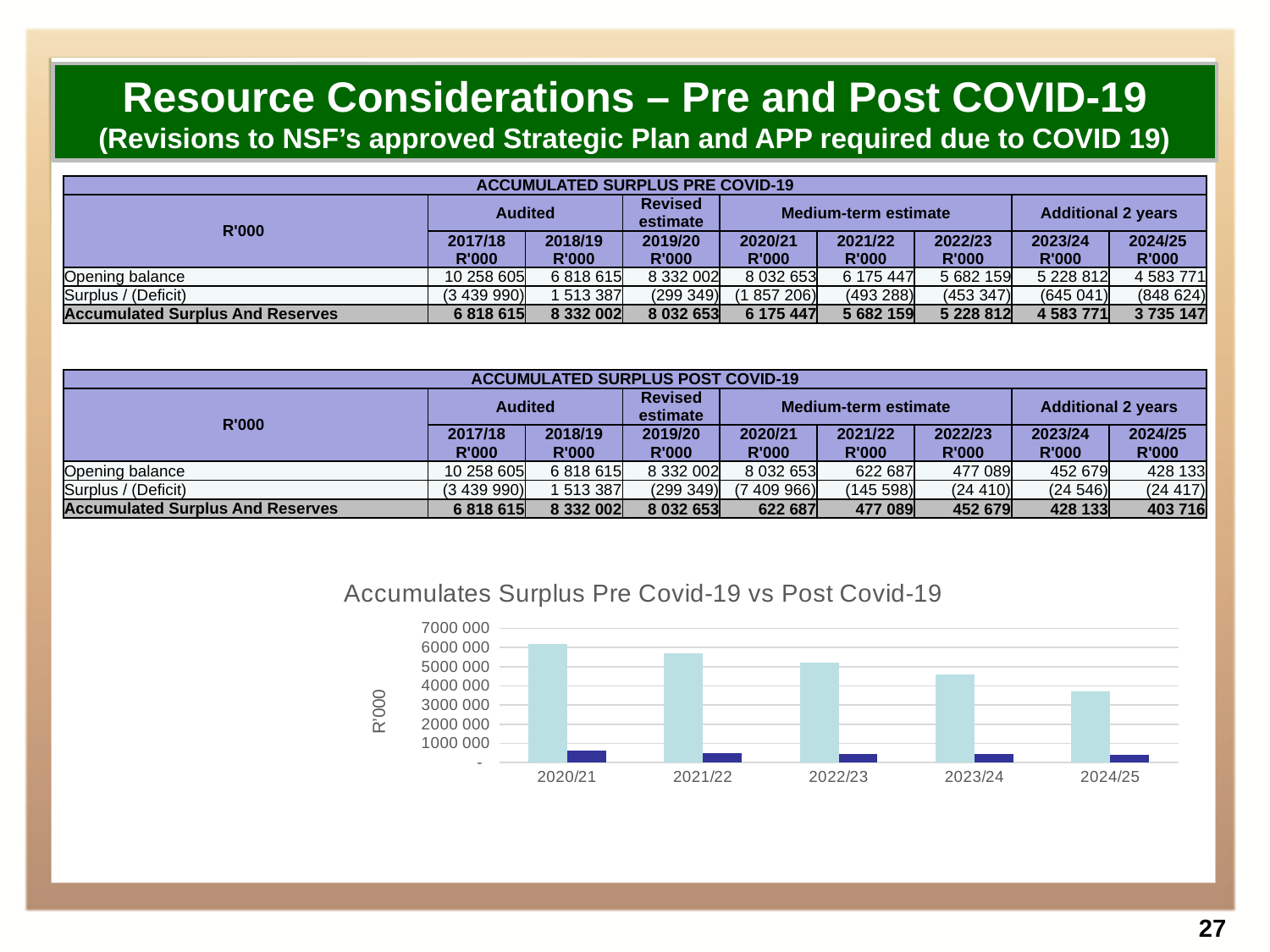
Is the dark blue bar for 2020/21 greater or less than 1000 000? less In which year is the light blue bar the shortest? 2024/25 What is the label on the vertical axis of the chart? R'000 Do the light blue bars rise or fall from 2020/21 to 2024/25? fall What is the title of the chart? Accumulates Surplus Pre Covid-19 vs Post Covid-19 What kind of chart is shown on the slide? bar chart How many bars are plotted for each year on the chart? 2 Is the light blue bar for 2024/25 greater or less than 4000 000? less In which year is the light blue bar the tallest? 2020/21 Is the light blue bar for 2021/22 greater or less than 5000 000? greater For 2020/21, which bar is taller, the light blue bar or the dark blue bar? the light blue bar How many financial-year categories are shown on the x axis of the chart? 5